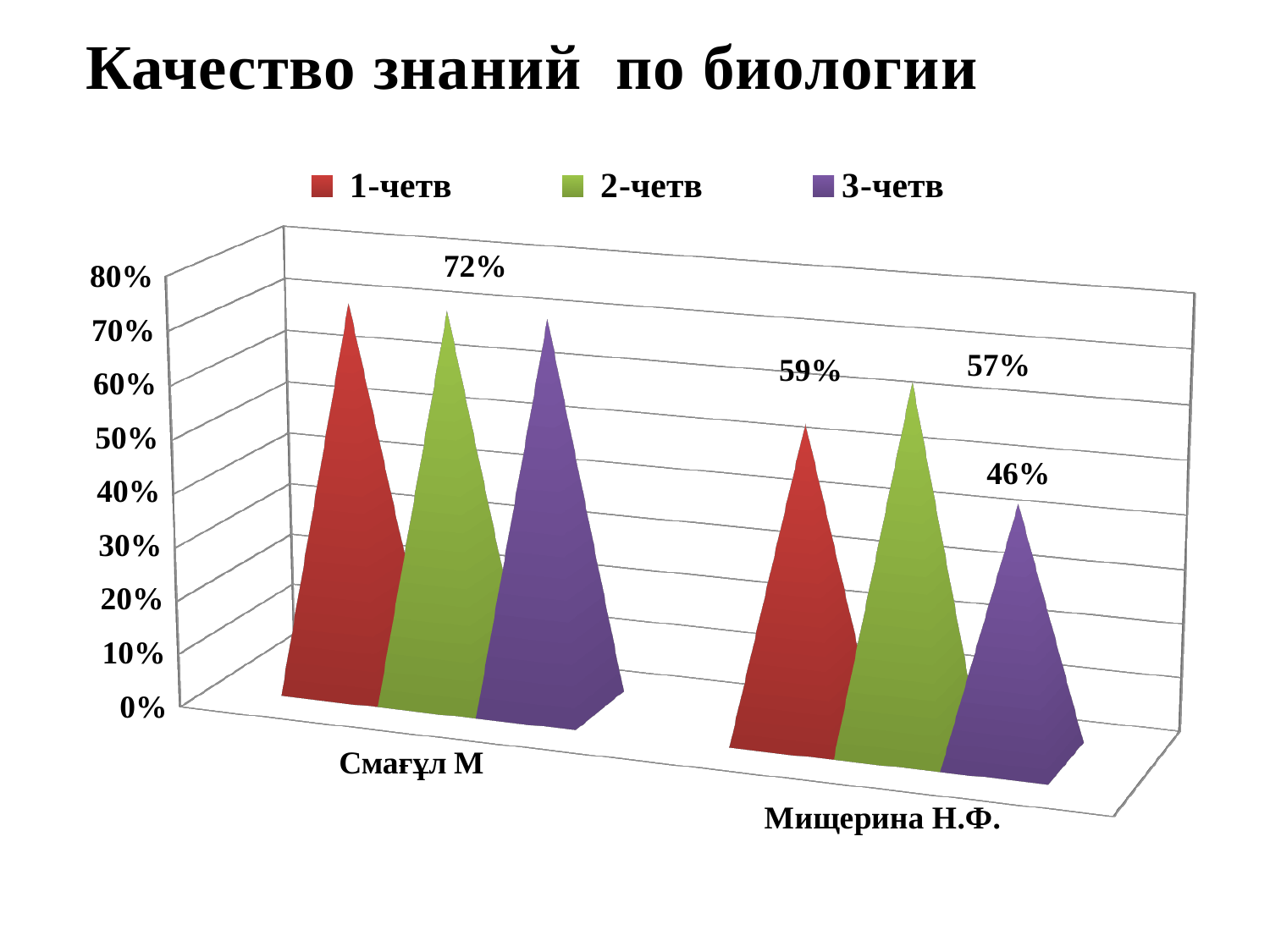
What is the value for 1-четв for Мищерина Н.Ф.? 59% Which quarter has the lowest value for Мищерина Н.Ф.? 3-четв What is the value for 2-четв for Мищерина Н.Ф.? 57% What is the value for 3-четв for Мищерина Н.Ф.? 46% For Мищерина Н.Ф., which is larger: the 1-четв value or the 3-четв value? 1-четв What is the title of the chart? Качество знаний по биологии How many series does the legend list? 3 What is the difference between the 1-четв and 3-четв values for Мищерина Н.Ф.? 13 percentage points What value is labelled above the bars for Смағұл М? 72% What kind of chart is shown on the slide? bar chart How many categories (teachers) are shown on the x axis? 2 Is the 1-четв value for Смағұл М greater or less than 50%? greater